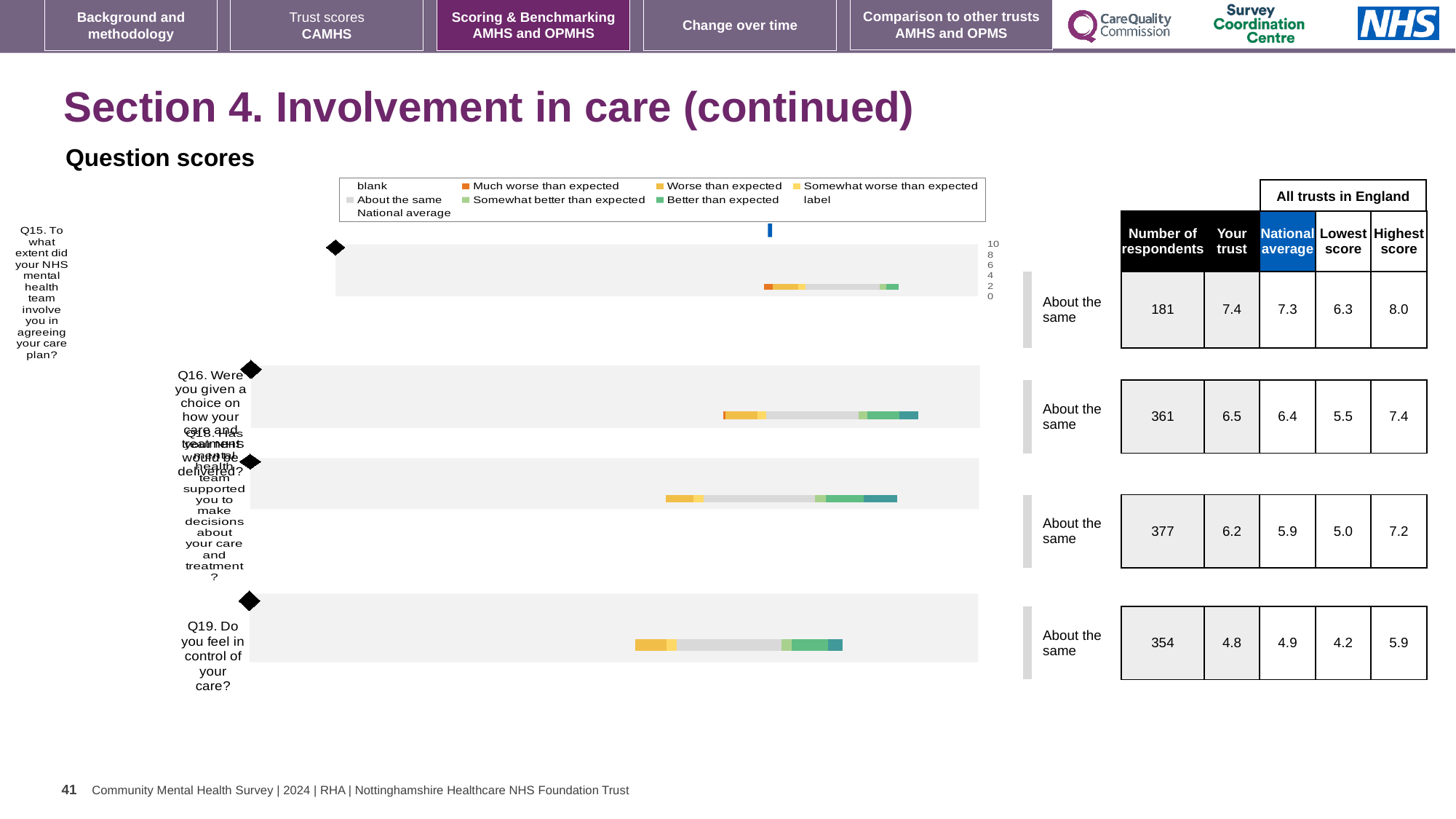
How many respondents answered Q18 (supported to make decisions about care and treatment)? 377 Which question has the highest 'Your trust' score? Q15 How many questions (bars) are plotted in the question scores chart? 4 For Q19, which is larger: the 'Your trust' score or the national average? National average What is the national average score for Q16 (choice on how care and treatment would be delivered)? 6.4 Which question has the lowest 'Your trust' score? Q19 In the question scores chart legend, what colour represents 'Much worse than expected'? orange What is the 'Your trust' score for Q15 (involving you in agreeing your care plan)? 7.4 What kind of chart is used to show the question scores on this slide? bar chart What is the highest score among all trusts in England for Q19 (feeling in control of your care)? 5.9 What is the difference between the highest score and the lowest score for Q18? 2.2 How many entries does the legend of the question scores chart list? 9